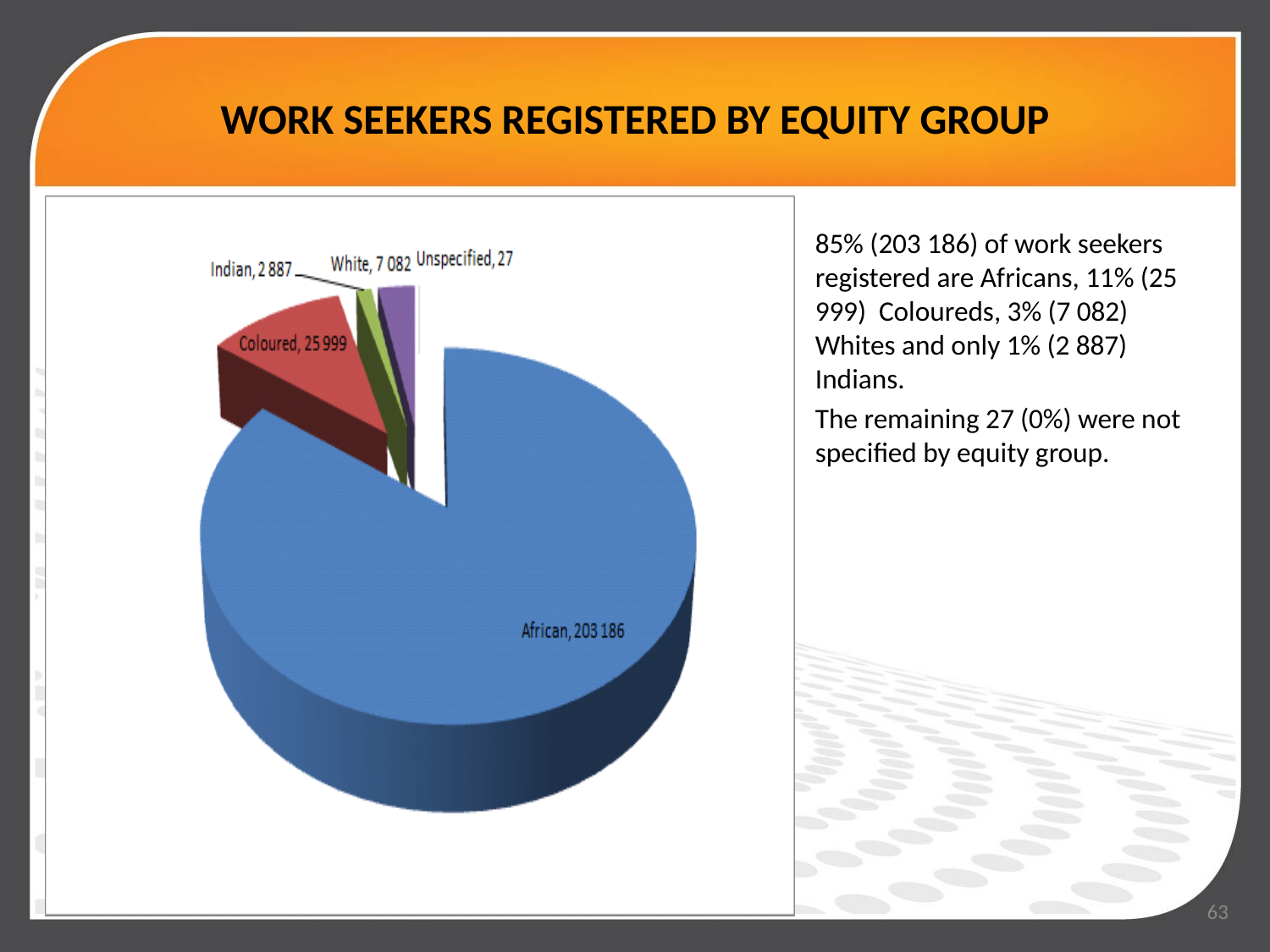
What is the difference between the African and Coloured values? 177 187 How many slices (equity groups) does the pie chart have? 5 What is the value shown for the White slice? 7 082 What type of chart is shown on the slide? Pie chart What is the value shown for the Unspecified slice? 27 Which equity group has the largest slice of the pie? African Which equity group has the smallest slice of the pie? Unspecified How many work seekers registered are African according to the chart? 203 186 Which is larger, the White slice or the Indian slice? White What is the value shown for the Indian slice? 2 887 What is the value shown for the Coloured slice? 25 999 What share of registered work seekers are African, as stated on the slide? 85%